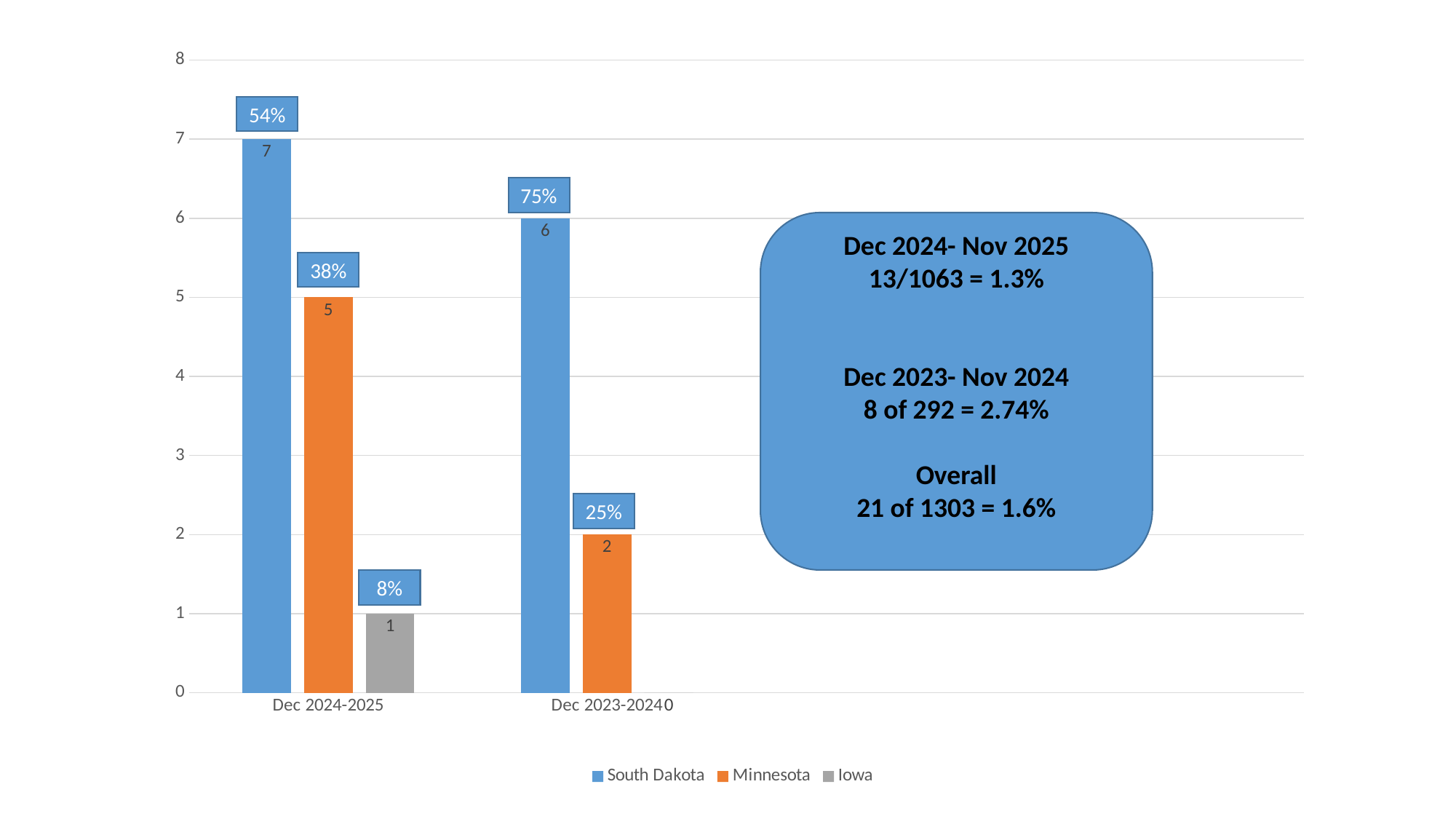
What kind of chart is shown on the slide? Bar chart What is the value for South Dakota in Dec 2023-2024? 6 Which is larger: South Dakota in Dec 2024-2025 or South Dakota in Dec 2023-2024? South Dakota in Dec 2024-2025 How many series does the legend list? 3 Which state has the lowest value in Dec 2024-2025? Iowa What is the value for Minnesota in Dec 2024-2025? 5 According to the text box, what is the overall rate shown on the slide? 21 of 1303 = 1.6% What is the value for Iowa in Dec 2024-2025? 1 What is the difference between the South Dakota and Minnesota values in Dec 2023-2024? 4 What percentage label is shown above the Minnesota bar for Dec 2023-2024? 25% Which state has the highest value in Dec 2024-2025? South Dakota What is the value for South Dakota in Dec 2024-2025? 7